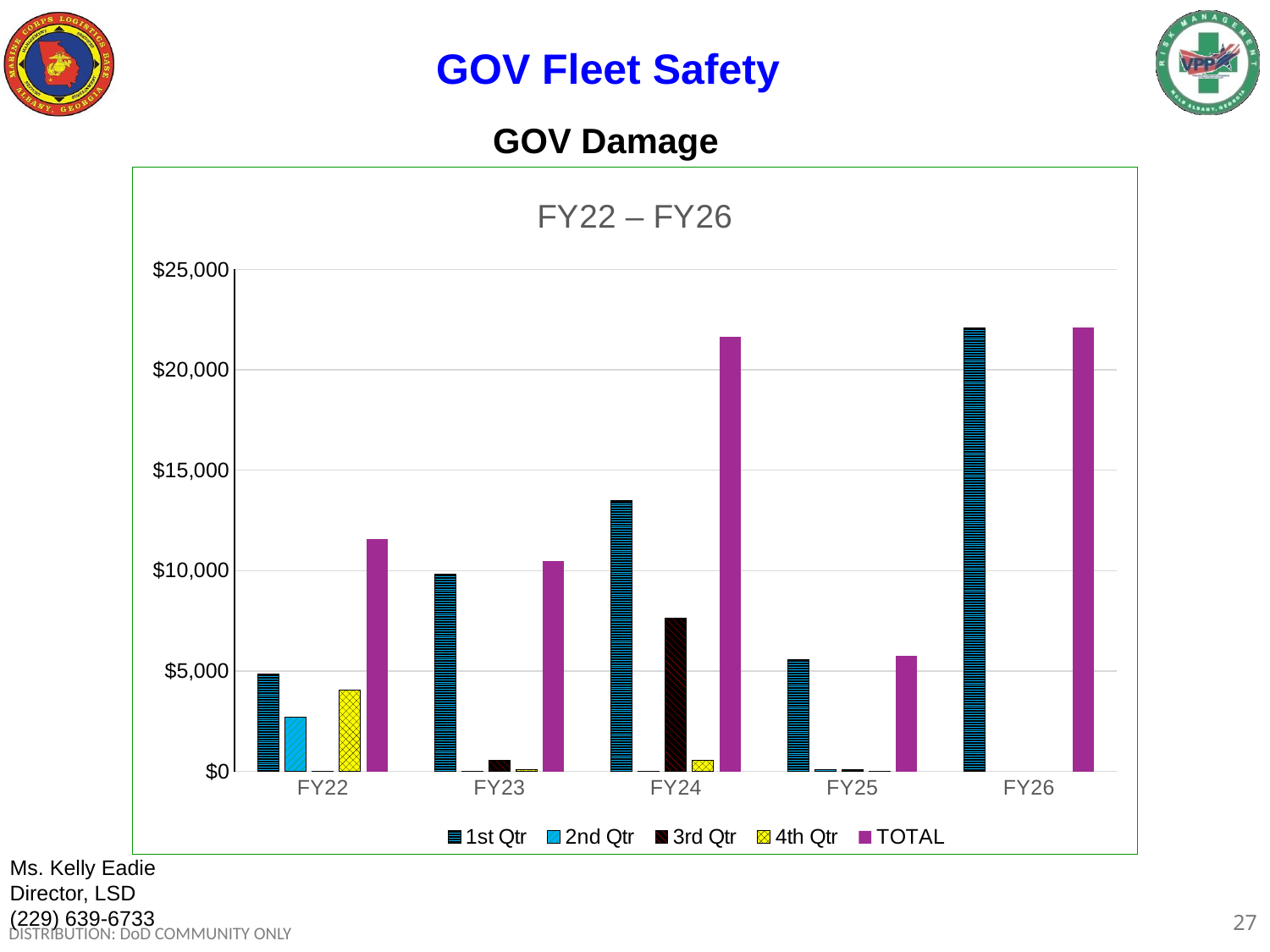
What is the title shown inside the chart area? FY22 – FY26 How many fiscal years are shown on the x axis? 5 Which fiscal year has the lowest TOTAL bar? FY25 Is the TOTAL value for FY24 greater or less than $20,000? greater Is the TOTAL value for FY22 greater or less than $10,000? greater In FY24, which is larger, the 1st Qtr bar or the 3rd Qtr bar? 1st Qtr How many series does the legend list? 5 What kind of chart is shown on the slide? Bar chart Is the TOTAL value for FY25 greater or less than $10,000? less Which is larger, the TOTAL for FY22 or the TOTAL for FY23? FY22 Which fiscal year has the highest 1st Qtr bar? FY26